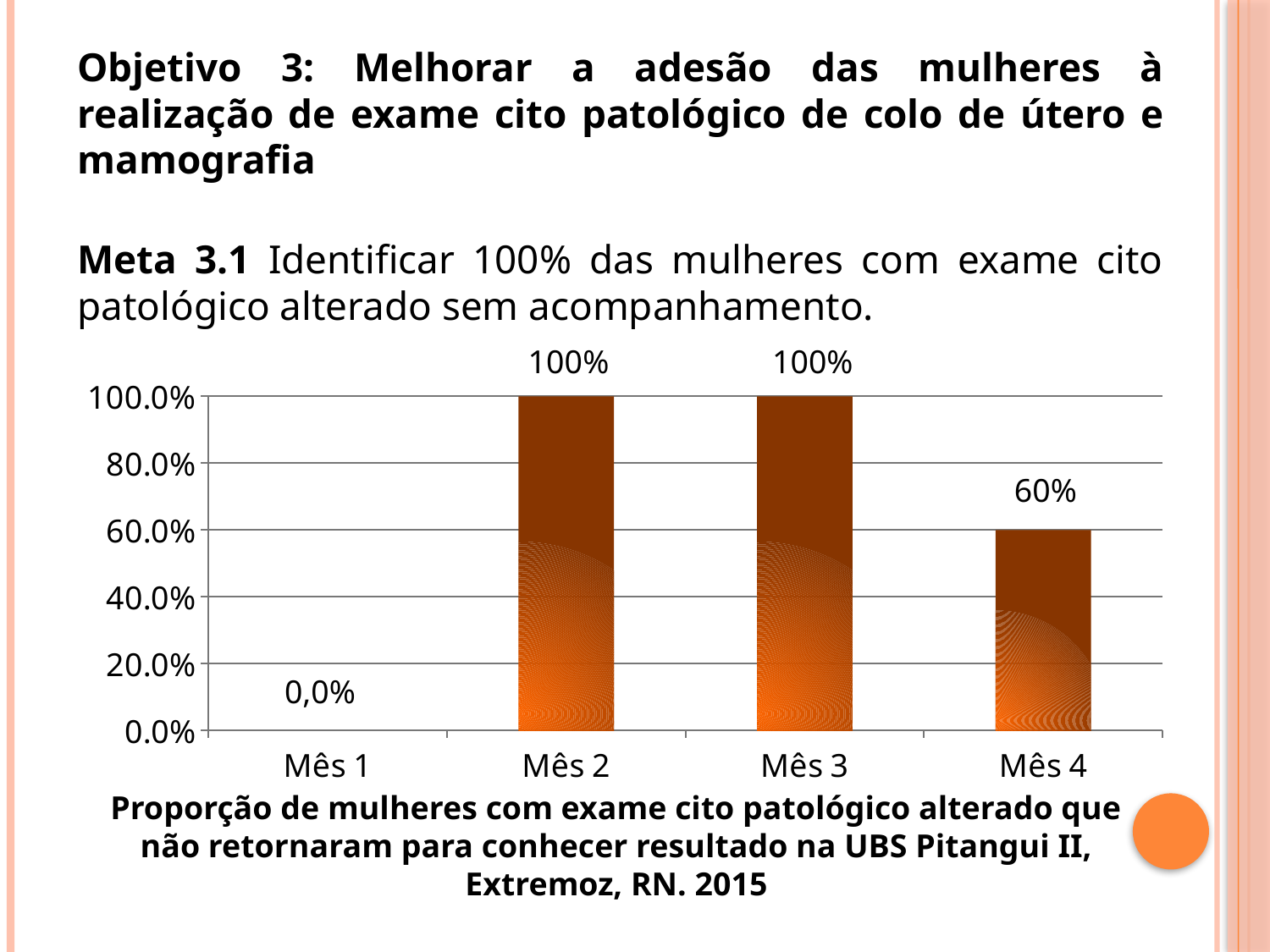
Which two months share the highest value? Mês 2 and Mês 3 Which month has the lowest value? Mês 1 Which is larger, the value for Mês 2 or the value for Mês 4? Mês 2 What is the highest tick value shown on the y axis? 100.0% Is the value for Mês 4 greater or less than 80.0%? less What is the value for Mês 2? 100% What kind of chart is shown on the slide? bar chart Do the values rise or fall from Mês 3 to Mês 4? fall What is the value for Mês 1? 0,0% How many months are shown on the x axis? 4 What is the difference between the values for Mês 3 and Mês 4? 40% What is the value for Mês 4? 60%